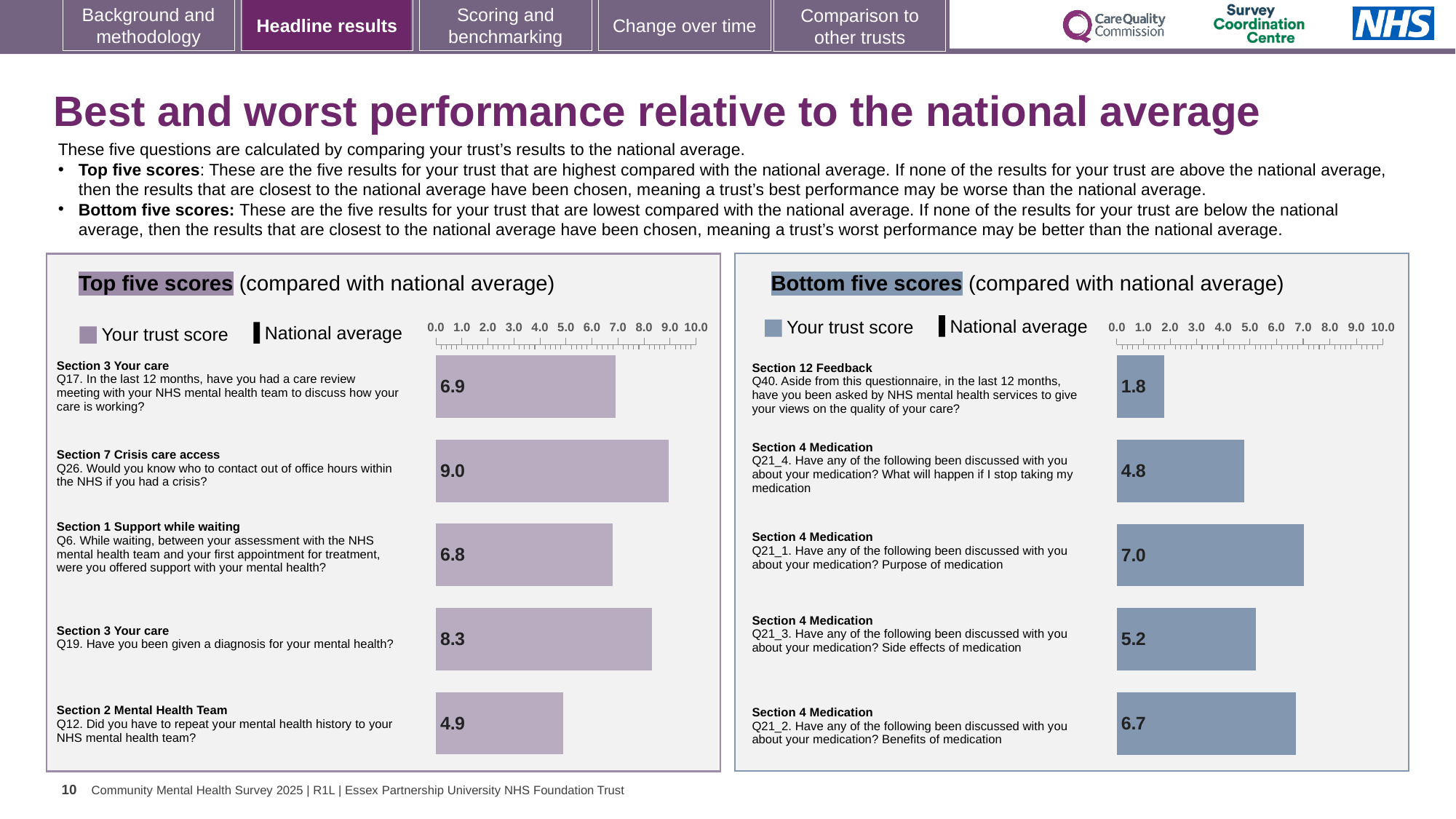
In the Bottom five scores chart, what is the trust score for Q40 (have you been asked by NHS mental health services to give your views on the quality of your care?)? 1.8 How many entries does the legend of the Top five scores chart list? 2 In the Bottom five scores chart, what is the trust score for Q21_1 (Purpose of medication)? 7.0 What type of chart is the Bottom five scores chart? Bar chart In the Top five scores chart, what is the trust score for Q26 (Would you know who to contact out of office hours within the NHS if you had a crisis?)? 9.0 In the Bottom five scores chart, which question has the lowest trust score? Q40 In the Top five scores chart, what is the difference between the trust scores for Q26 and Q12? 4.1 In the Bottom five scores chart, which has the larger trust score, Q21_4 or Q21_3? Q21_3 In the Top five scores chart, which question has the highest trust score? Q26 In the Bottom five scores chart, what is the difference between the trust scores for Q21_1 and Q40? 5.2 How many bars are shown in the Top five scores chart? 5 In the Top five scores chart, what is the trust score for Q12 (Did you have to repeat your mental health history to your NHS mental health team?)? 4.9